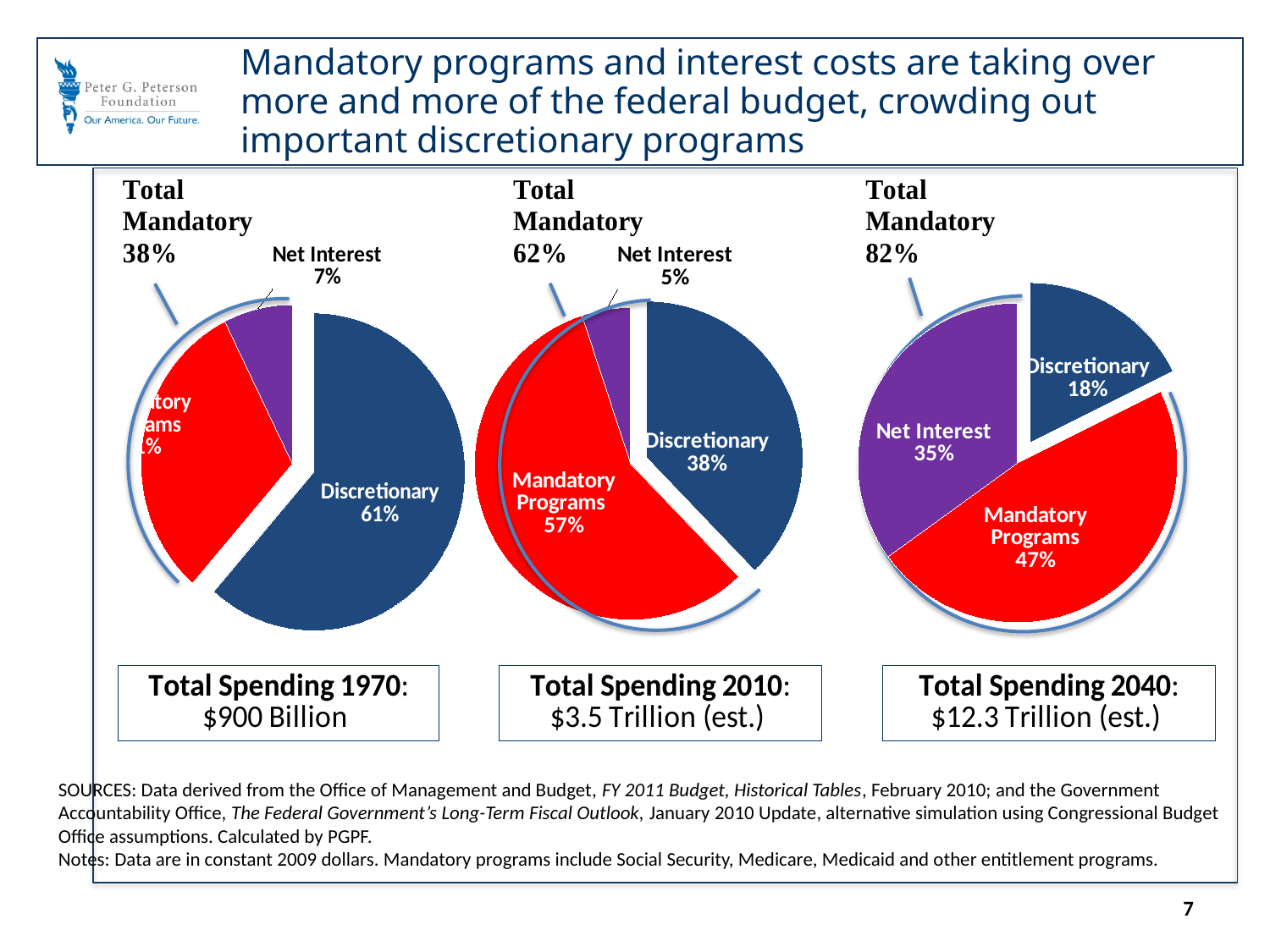
In the 2010 pie chart, what share of spending is Net Interest? 5% In the 2010 pie chart, which is larger, Discretionary or Mandatory Programs? Mandatory Programs In the 2040 pie chart, what share of spending is Net Interest? 35% What is the Total Mandatory share shown above the 2040 pie chart? 82% In the 2010 pie chart, which category has the smallest slice? Net Interest In the 2040 pie chart, which category has the largest slice? Mandatory Programs How many slices does the 2040 pie chart have? 3 In the 2040 pie chart, what is the difference in percentage points between Mandatory Programs and Discretionary? 29 In the 1970 pie chart, what share of spending is Discretionary? 61% In the 1970 pie chart, what share of spending is Net Interest? 7% In the 2010 pie chart, what share of spending is Mandatory Programs? 57% What type of chart is used to show the 1970 spending breakdown? Pie chart